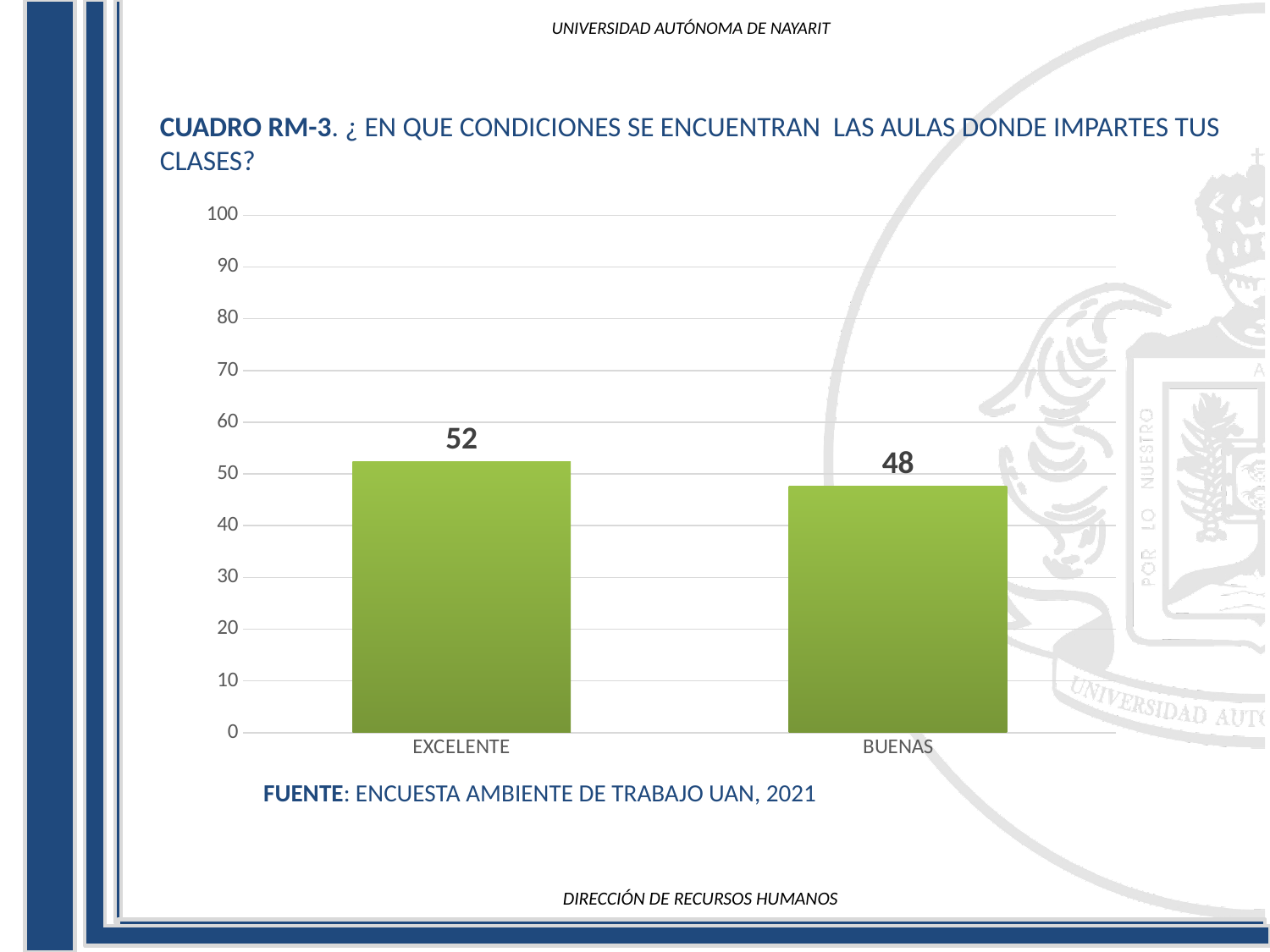
Which category has the lowest value? BUENAS Which is larger, the value for EXCELENTE or the value for BUENAS? EXCELENTE Is the value for BUENAS greater or less than 50? less What is the value for BUENAS? 48 Is the value for EXCELENTE greater or less than 50? greater How many categories are shown on the x axis? 2 Which category has the highest value? EXCELENTE What is the difference between the values for EXCELENTE and BUENAS? 4 What is the value for EXCELENTE? 52 What is the maximum value shown on the vertical axis? 100 What kind of chart is shown on the slide? bar chart What is the total of the two values shown in the chart? 100